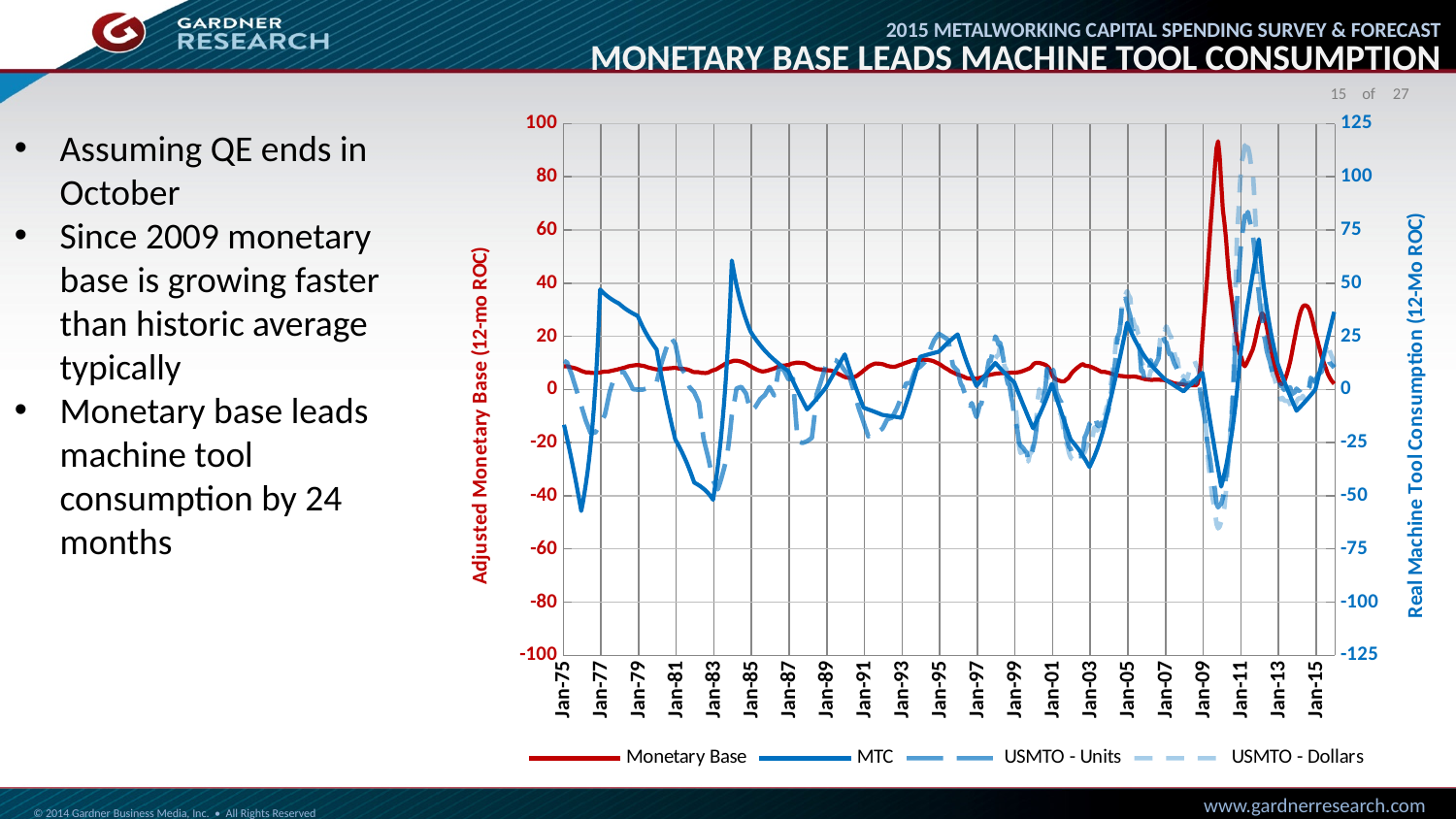
Between Jan-09 and its peak shortly after, does the Monetary Base series rise or fall? Rise Is the peak value of the Monetary Base series around 2009-2010 greater or less than 80 on the left axis? greater Which series are listed in the chart legend? Monetary Base, MTC, USMTO - Units, USMTO - Dollars What is the highest value shown on the right vertical axis? 125 Is the peak of the Monetary Base series near Jan-13 greater or less than 40 on the left axis? less Which is larger for the Monetary Base series: its peak shortly after Jan-09 or its peak near Jan-13? The peak shortly after Jan-09 What kind of chart is shown on the slide? Line chart How many series does the legend list? 4 Is the lowest point of the MTC series near Jan-77 greater or less than -25 on the right axis? less How many year labels are shown along the x axis? 21 What is the title of the left vertical axis? Adjusted Monetary Base (12-mo ROC)